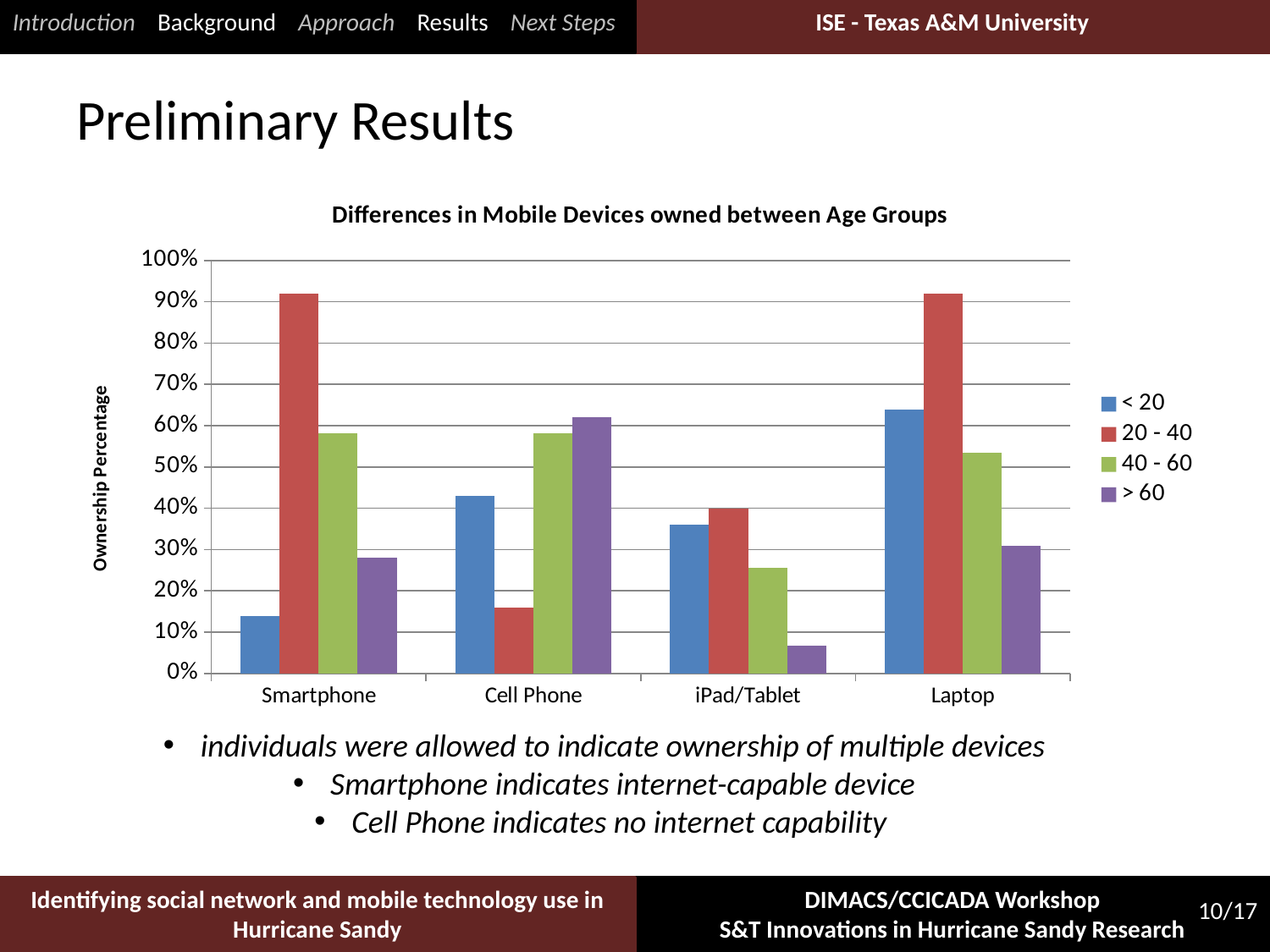
Is the iPad/Tablet ownership percentage for the > 60 group greater or less than 10%? less How many age-group series does the legend list? 4 For Cell Phone, which age group has the lowest ownership percentage? 20 - 40 For Cell Phone, which is larger: the ownership percentage for < 20 or for > 60? > 60 How many device categories are shown on the x axis? 4 For Smartphone, which age group has the highest ownership percentage? 20 - 40 For Laptop, which is larger: the ownership percentage for < 20 or for 40 - 60? < 20 What is the title of the chart? Differences in Mobile Devices owned between Age Groups Is the Cell Phone ownership percentage for the 20 - 40 group greater or less than 20%? less Is the Smartphone ownership percentage for the 20 - 40 group greater or less than 80%? greater For iPad/Tablet, which age group has the lowest ownership percentage? > 60 What kind of chart is shown on the slide? bar chart